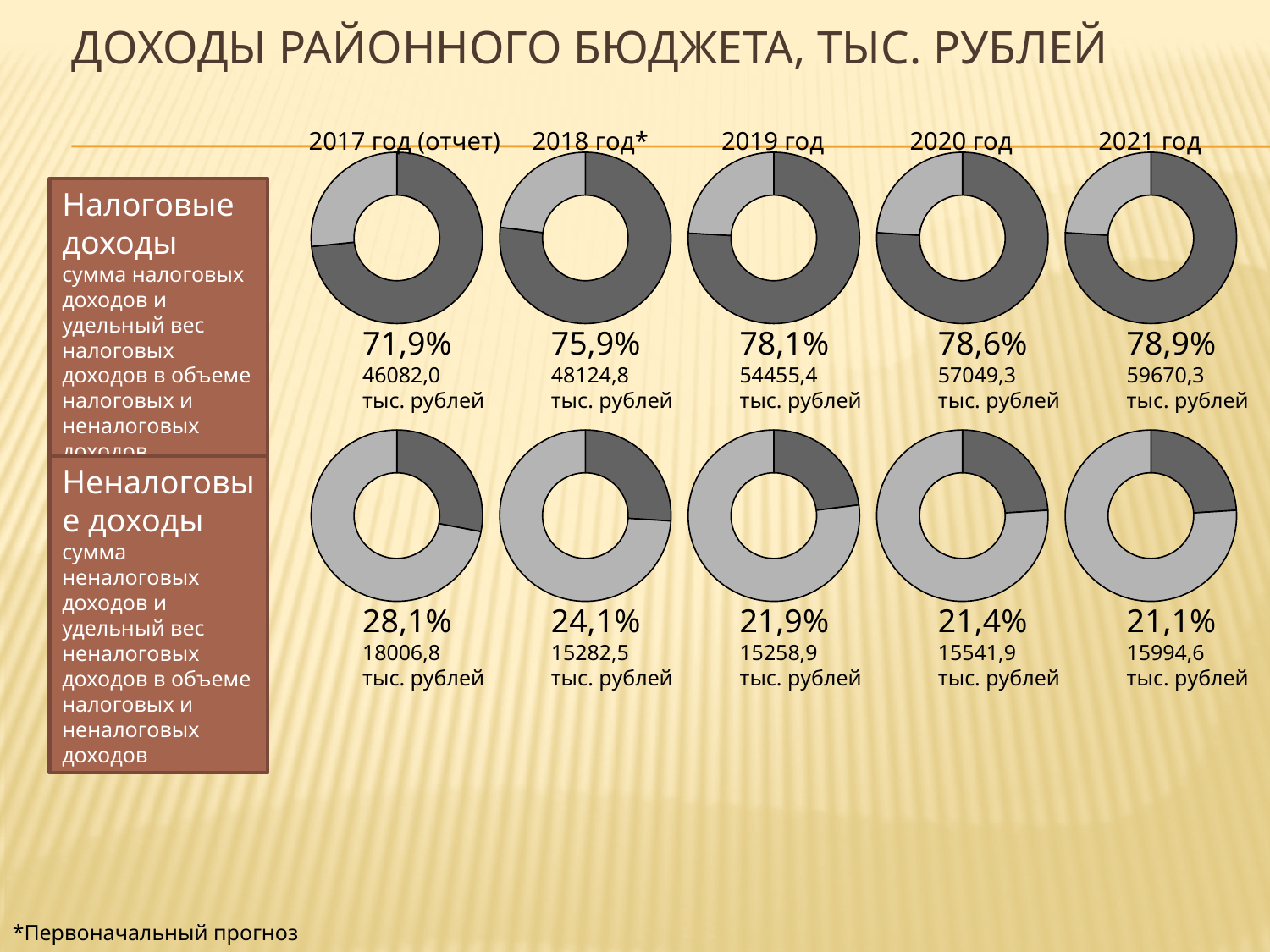
What is the difference in percentage points between the tax revenue share in 2021 год and in 2017 год (отчет)? 7,0 By how much does the amount of tax revenues (Налоговые доходы) in 2021 год exceed that in 2017 год (отчет)? 13588,3 тыс. рублей In which year is the share of non-tax revenues (Неналоговые доходы) the lowest? 2021 год What share do non-tax revenues (Неналоговые доходы) make up in 2019 год? 21,9% How many donut charts are shown on the slide in total? 10 What kind of charts are used on the slide to show the shares of tax and non-tax revenues? Donut (ring) charts Which is larger: the amount of non-tax revenues (Неналоговые доходы) in 2017 год (отчет) or in 2020 год? 2017 год (отчет) What share of revenues do tax revenues (Налоговые доходы) make up in 2017 год (отчет)? 71,9% What is the amount of non-tax revenues (Неналоговые доходы) shown for 2018 год*? 15282,5 тыс. рублей What is the amount of tax revenues (Налоговые доходы) shown for 2021 год? 59670,3 тыс. рублей Does the share of tax revenues (Налоговые доходы) rise or fall from 2017 to 2021? Rise In which year is the share of tax revenues (Налоговые доходы) the highest? 2021 год